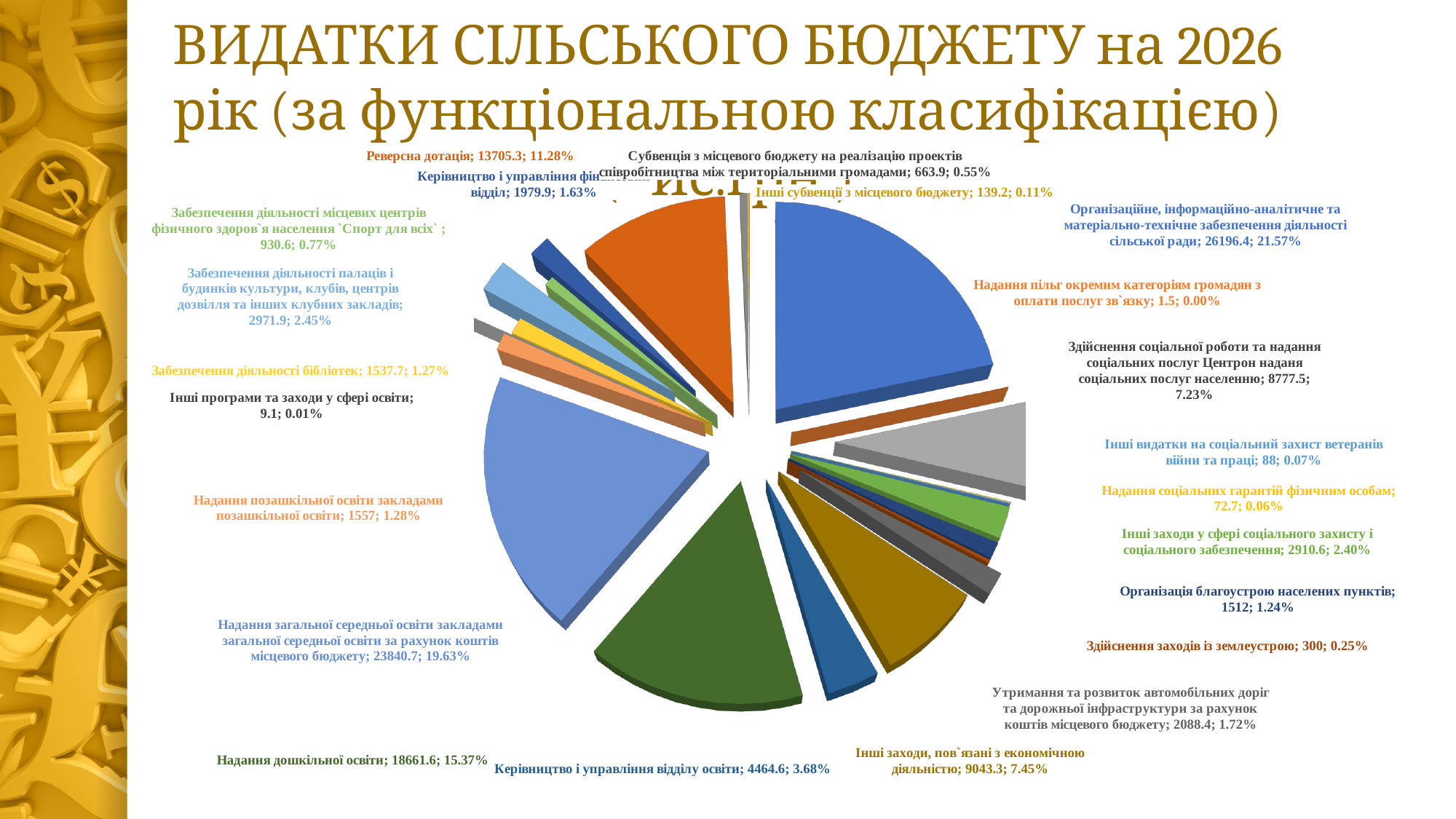
Which category has the largest share of the pie? Організаційне, інформаційно-аналітичне та матеріально-технічне забезпечення діяльності сільської ради What percentage share is shown for Надання дошкільної освіти? 15.37% What is the value shown for Реверсна дотація? 13705.3 What kind of chart is shown on the slide? pie chart Which category has the smallest value in the chart? Надання пільг окремим категоріям громадян з оплати послуг зв`язку What percentage share is shown for Надання загальної середньої освіти закладами загальної середньої освіти за рахунок коштів місцевого бюджету? 19.63% What percentage share is shown for Керівництво і управління відділу освіти? 3.68% What is the difference between the value for Надання дошкільної освіти and the value for Реверсна дотація? 4956.3 Which is larger: the value for Інші заходи, пов`язані з економічною діяльністю or the value for Здійснення соціальної роботи та надання соціальних послуг? Інші заходи, пов`язані з економічною діяльністю What is the value shown for Здійснення заходів із землеустрою? 300 What is the value shown for Організація благоустрою населених пунктів? 1512 What is the title of the slide? ВИДАТКИ СІЛЬСЬКОГО БЮДЖЕТУ на 2026 рік (за функціональною класифікацією)